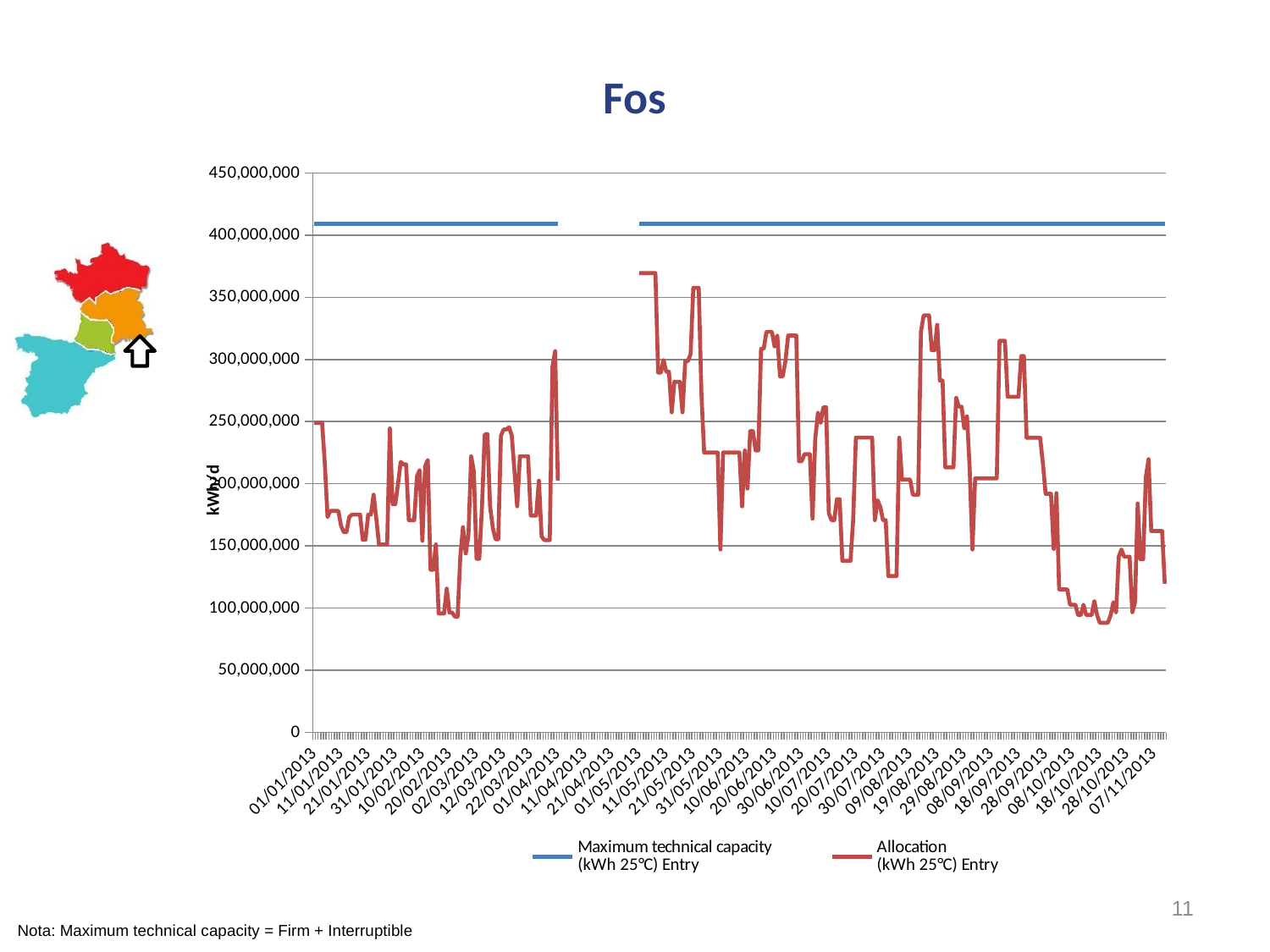
What kind of chart is shown on the slide? line chart Does the Allocation (kWh 25°C) Entry series rise or fall between 28/09/2013 and 18/10/2013? fall Which series has the higher values throughout the chart, Maximum technical capacity (kWh 25°C) Entry or Allocation (kWh 25°C) Entry? Maximum technical capacity (kWh 25°C) Entry Is the Allocation (kWh 25°C) Entry value on 07/11/2013 greater or less than 150,000,000? greater Is the value of Maximum technical capacity (kWh 25°C) Entry greater or less than 400,000,000? greater What is the title of the chart? Fos What is the label on the vertical axis of the chart? kWh/d Does the Maximum technical capacity (kWh 25°C) Entry series rise, fall or stay flat across the chart? stay flat Is the Allocation (kWh 25°C) Entry value on 18/10/2013 greater or less than 150,000,000? less How many series does the legend list? 2